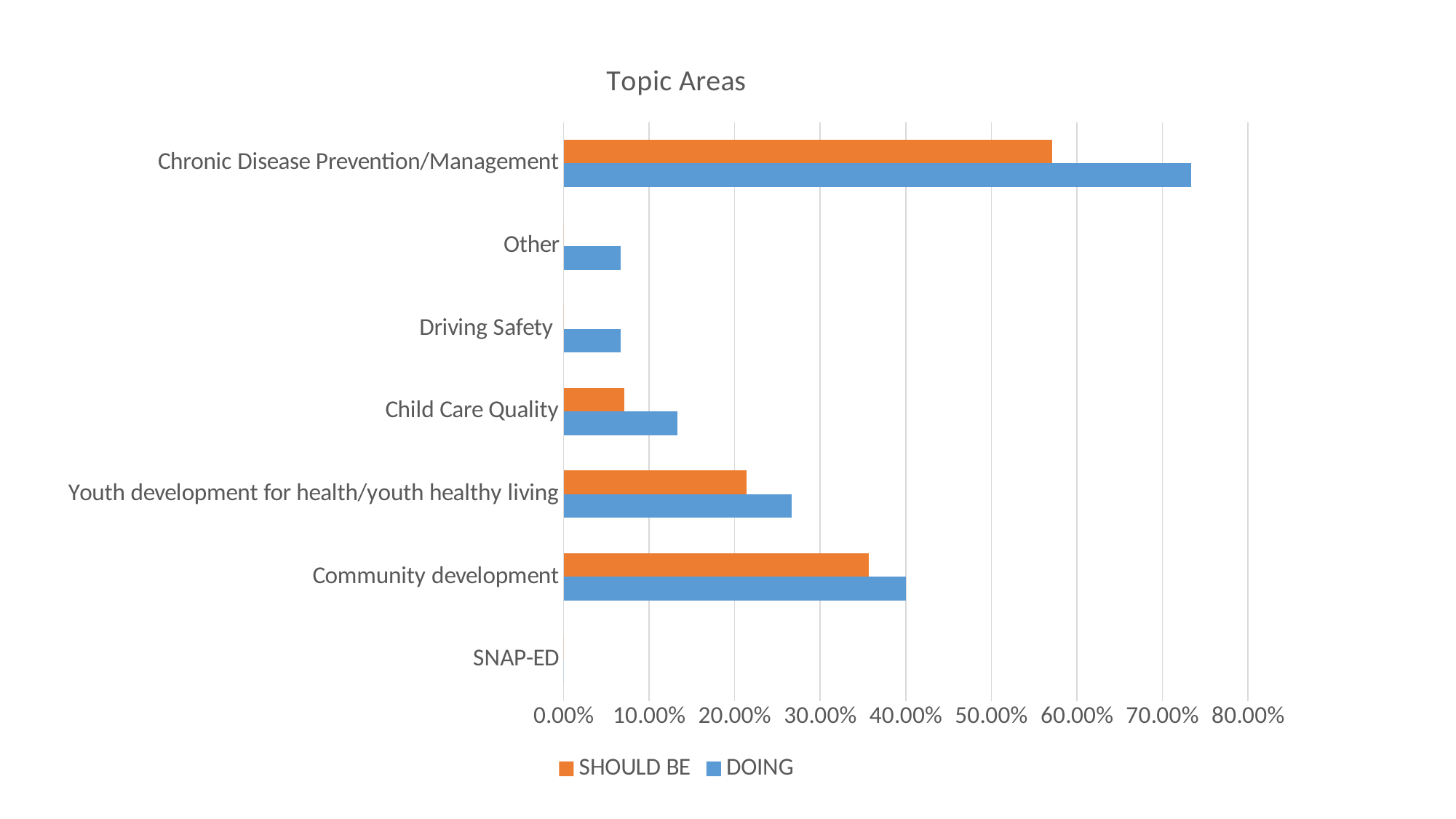
What kind of chart is shown on the slide? bar chart How many series does the legend list? 2 How many topic area categories are shown on the chart? 7 Is the DOING value for Chronic Disease Prevention/Management greater or less than 70.00%? greater For Community development, which is larger: the DOING value or the SHOULD BE value? DOING Which topic area has the highest DOING value? Chronic Disease Prevention/Management Is the SHOULD BE value for Chronic Disease Prevention/Management greater or less than 60.00%? less Is the DOING value for Child Care Quality greater or less than 10.00%? greater What colour represents the DOING series? blue Which topic area has the highest SHOULD BE value? Chronic Disease Prevention/Management What is the title of the chart? Topic Areas